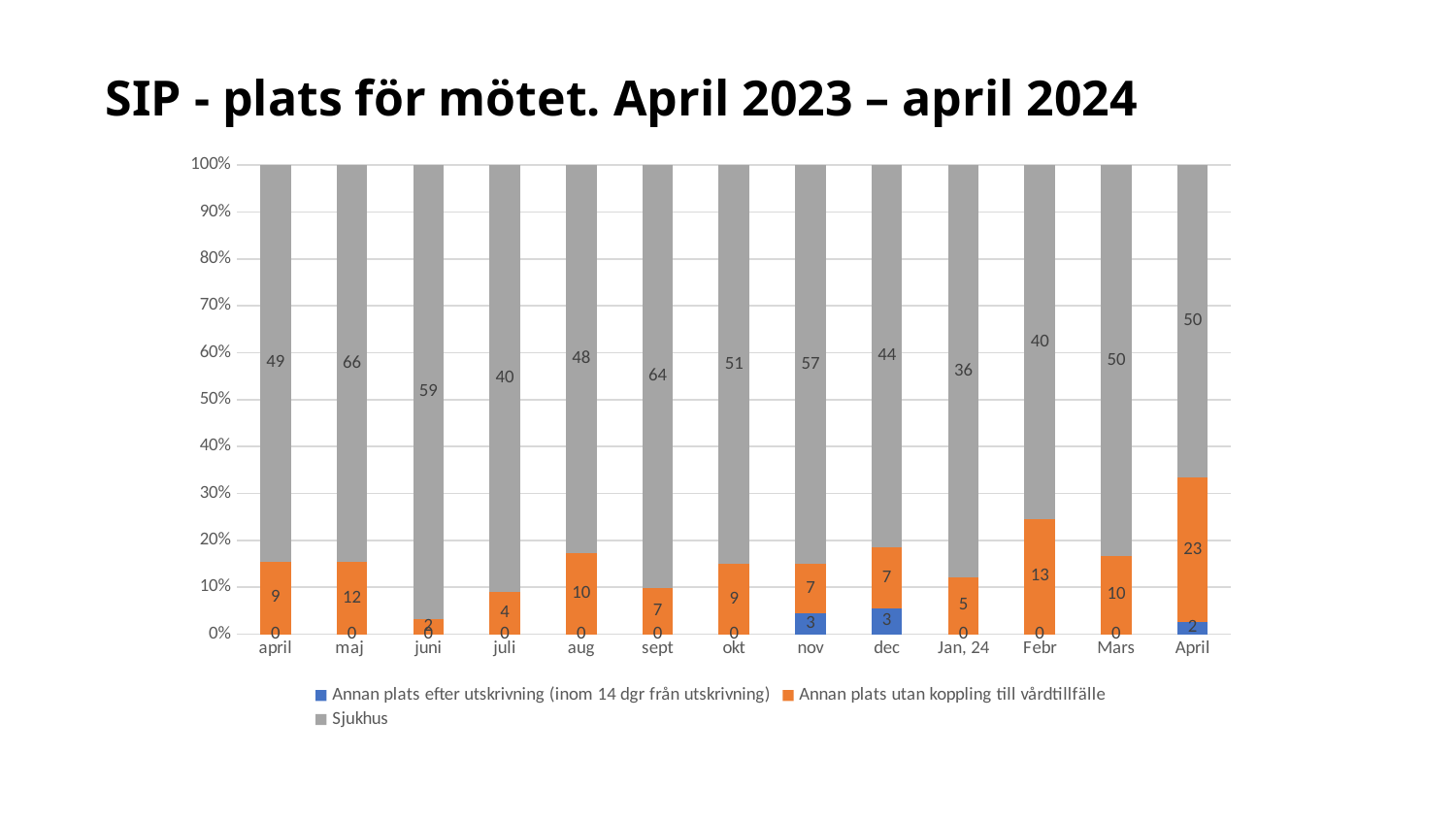
What is the value for 'Annan plats utan koppling till vårdtillfälle' in April (2024)? 23 Which month has the lowest Sjukhus value? Jan, 24 What is the value for 'Annan plats efter utskrivning (inom 14 dgr från utskrivning)' in nov? 3 Which is larger, the 'Annan plats utan koppling till vårdtillfälle' value for Febr or for Mars? Febr What is the total of the three values in the bar for April (2024)? 75 What kind of chart is shown on the slide? Stacked bar chart What is the Sjukhus value for maj? 66 How many months are shown on the x axis? 13 How many series does the legend list? 3 What is the difference between the Sjukhus values for maj and Jan, 24? 30 Which month has the highest Sjukhus value? maj What is the title of the chart? SIP - plats för mötet. April 2023 – april 2024